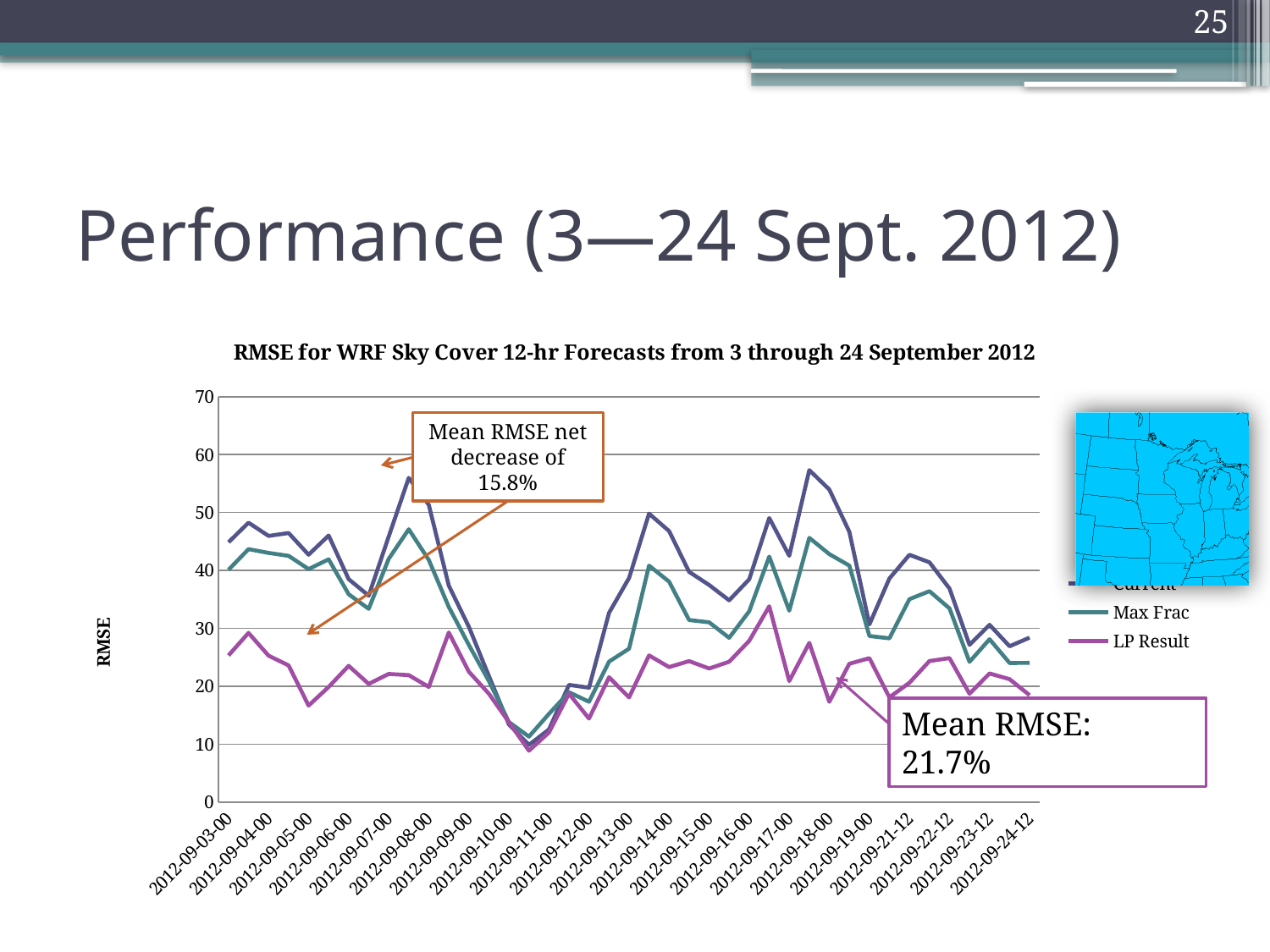
Is the Current value at 2012-09-03-00 greater or less than 40? greater At 2012-09-18-00, which series has the larger value, Max Frac or LP Result? Max Frac Is the Current value at 2012-09-18-00 greater or less than 50? greater Is the LP Result value at 2012-09-03-00 greater or less than 30? less What is the label on the chart's vertical axis? RMSE What is the title of the chart? RMSE for WRF Sky Cover 12-hr Forecasts from 3 through 24 September 2012 At 2012-09-03-00, which series has the larger value, Current or LP Result? Current How many series does the chart's legend list? 3 Between 2012-09-08-00 and 2012-09-11-00, does the Current series rise or fall? fall What kind of chart is shown on the slide? line chart Which series has the lowest values across most of the chart? LP Result